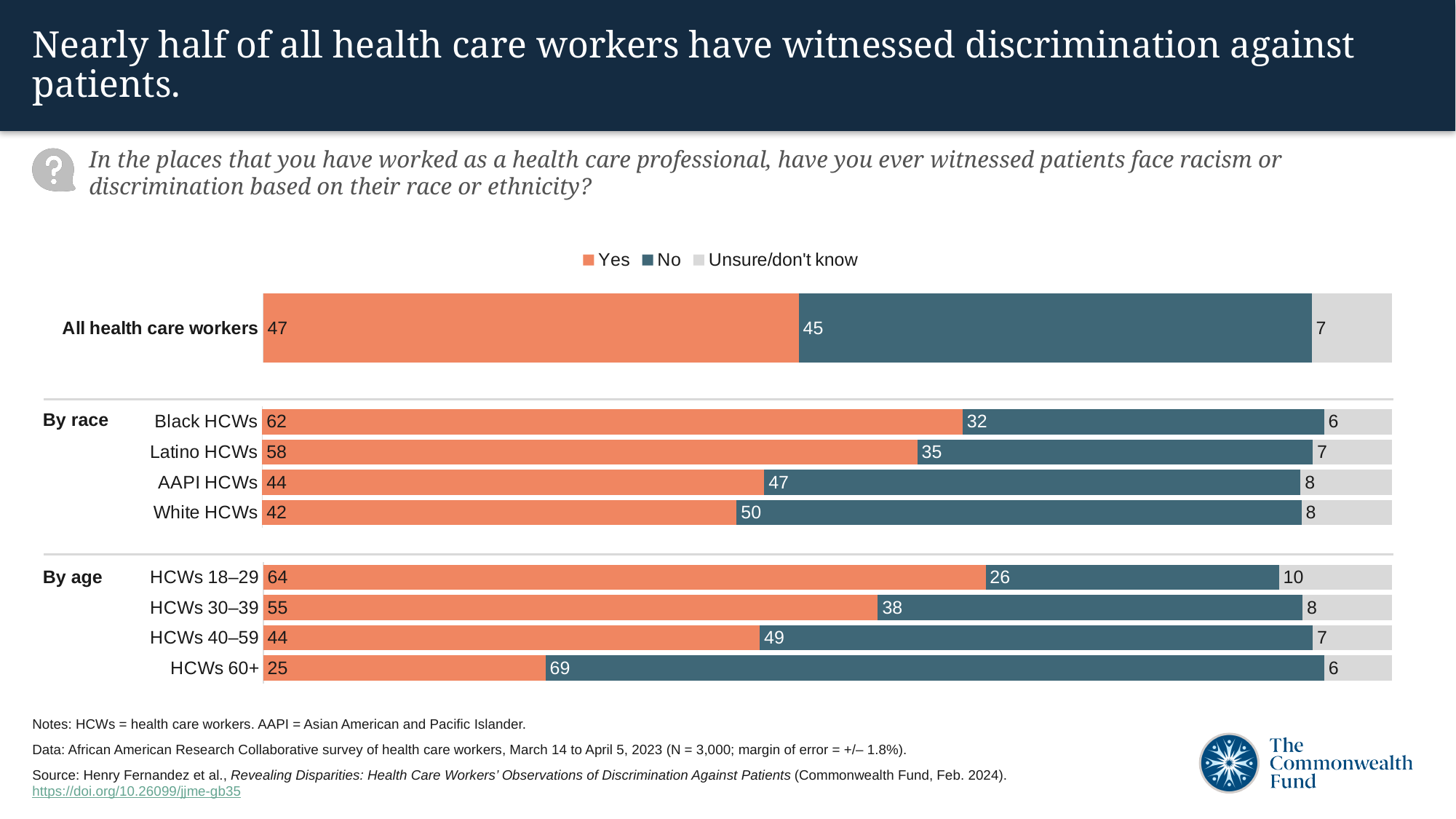
How many categories (bars) are shown in the chart? 9 How many series does the legend list? 3 What is the difference between the Yes values for Black HCWs and White HCWs? 20 What percentage of all health care workers answered Yes? 47 What kind of chart is shown? Stacked bar chart Which category has the lowest Yes value? HCWs 60+ What is the Unsure/don't know value for HCWs 18–29? 10 Among the race groups, which has the highest Yes value? Black HCWs Which category has the highest Yes value? HCWs 18–29 Which is larger, the Yes value for Latino HCWs or the Yes value for AAPI HCWs? Latino HCWs What is the No value for HCWs 60+? 69 What is the total of the stacked bar for HCWs 30–39? 101